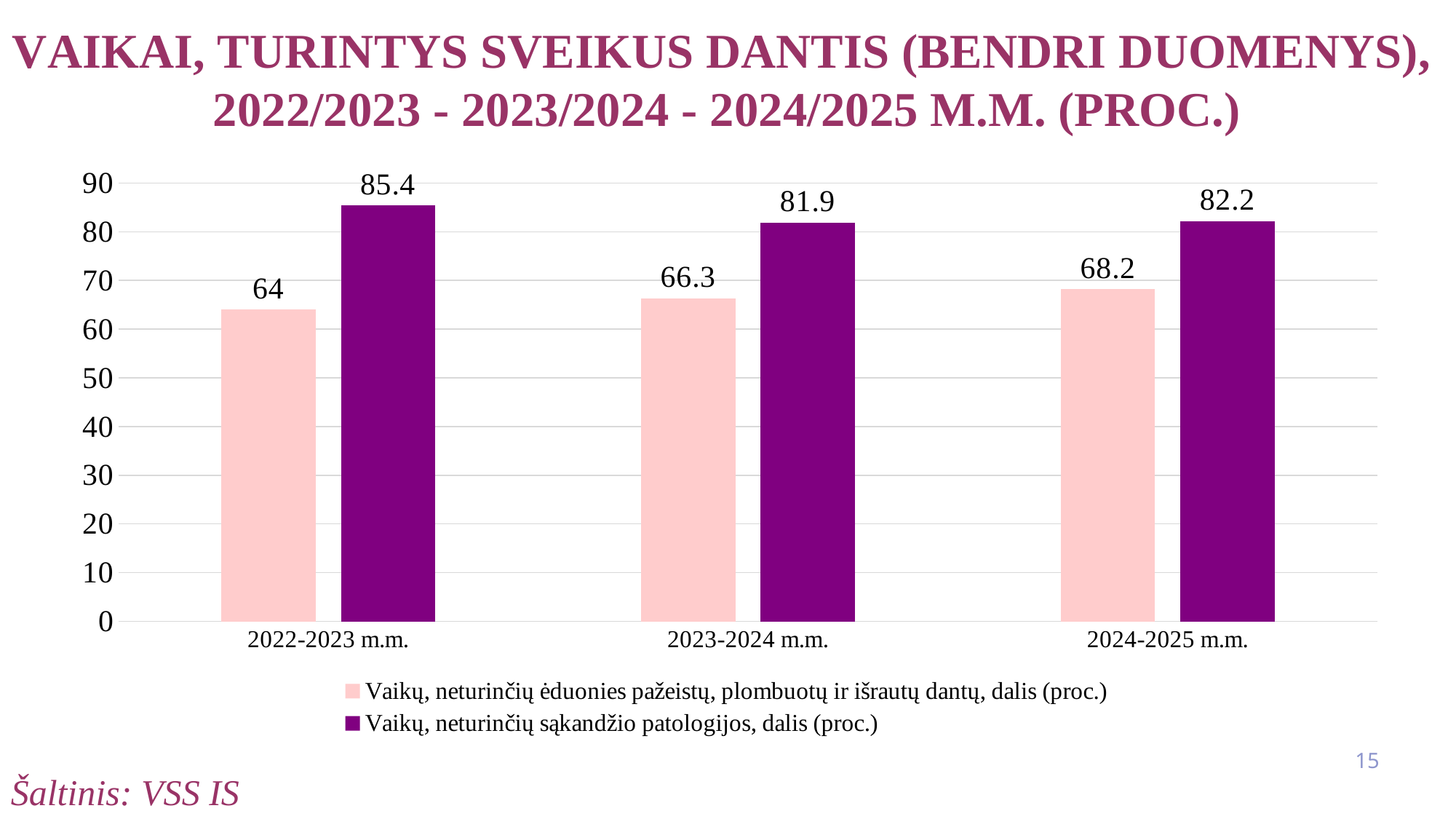
Does the value for 'Vaikų, neturinčių ėduonies pažeistų, plombuotų ir išrautų dantų, dalis (proc.)' rise or fall across the school years? Rise How many school years are shown on the x axis? 3 By how much did 'Vaikų, neturinčių ėduonies pažeistų, plombuotų ir išrautų dantų, dalis (proc.)' change from 2022-2023 m.m. to 2024-2025 m.m.? 4.2 What is the value for 'Vaikų, neturinčių sąkandžio patologijos, dalis (proc.)' in 2023-2024 m.m.? 81.9 What is the difference between the two series' values in 2022-2023 m.m.? 21.4 What kind of chart is shown on the slide? Bar chart In which school year is the value for 'Vaikų, neturinčių ėduonies pažeistų, plombuotų ir išrautų dantų, dalis (proc.)' lowest? 2022-2023 m.m. In which school year is the value for 'Vaikų, neturinčių sąkandžio patologijos, dalis (proc.)' highest? 2022-2023 m.m. Which is larger: the value for 'Vaikų, neturinčių sąkandžio patologijos, dalis (proc.)' in 2023-2024 m.m. or in 2024-2025 m.m.? 2024-2025 m.m. What is the value for 'Vaikų, neturinčių ėduonies pažeistų, plombuotų ir išrautų dantų, dalis (proc.)' in 2022-2023 m.m.? 64 How many series does the legend list? 2 What is the value for 'Vaikų, neturinčių ėduonies pažeistų, plombuotų ir išrautų dantų, dalis (proc.)' in 2024-2025 m.m.? 68.2